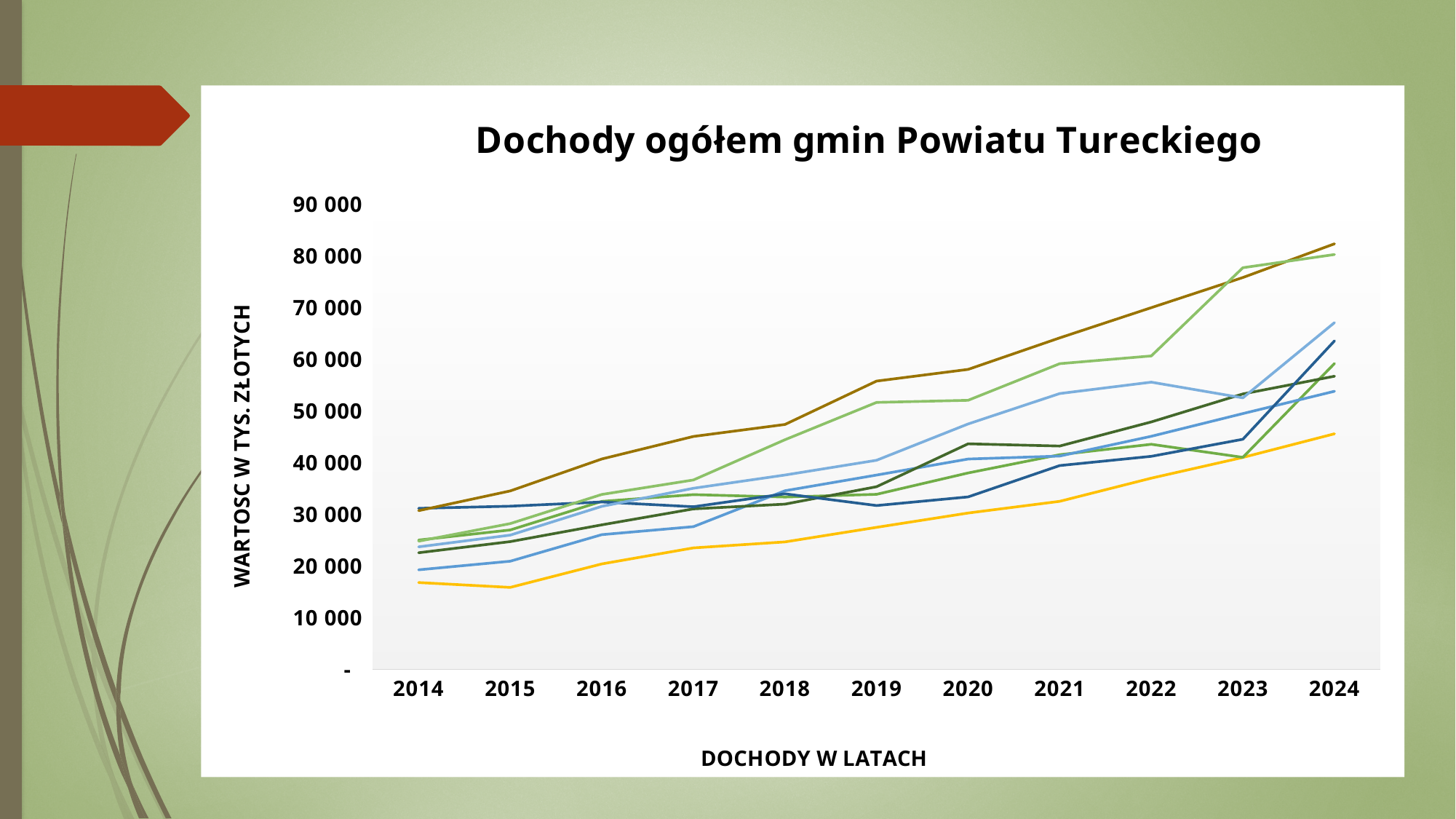
Is the lowest value plotted for 2014 greater or less than 20 000? less What is the label of the vertical axis? WARTOSC W TYS. ZŁOTYCH What is the first year shown on the x axis? 2014 What type of chart is shown on the slide? line chart What is the last year shown on the x axis? 2024 Is the highest value plotted for 2024 greater or less than 80 000? greater Do the lines generally rise or fall from 2014 to 2024? rise Is the highest value plotted for 2014 greater or less than 40 000? less What is the title of the chart? Dochody ogółem gmin Powiatu Tureckiego What is the highest tick value shown on the vertical axis? 90 000 How many years are shown on the x axis of the chart? 11